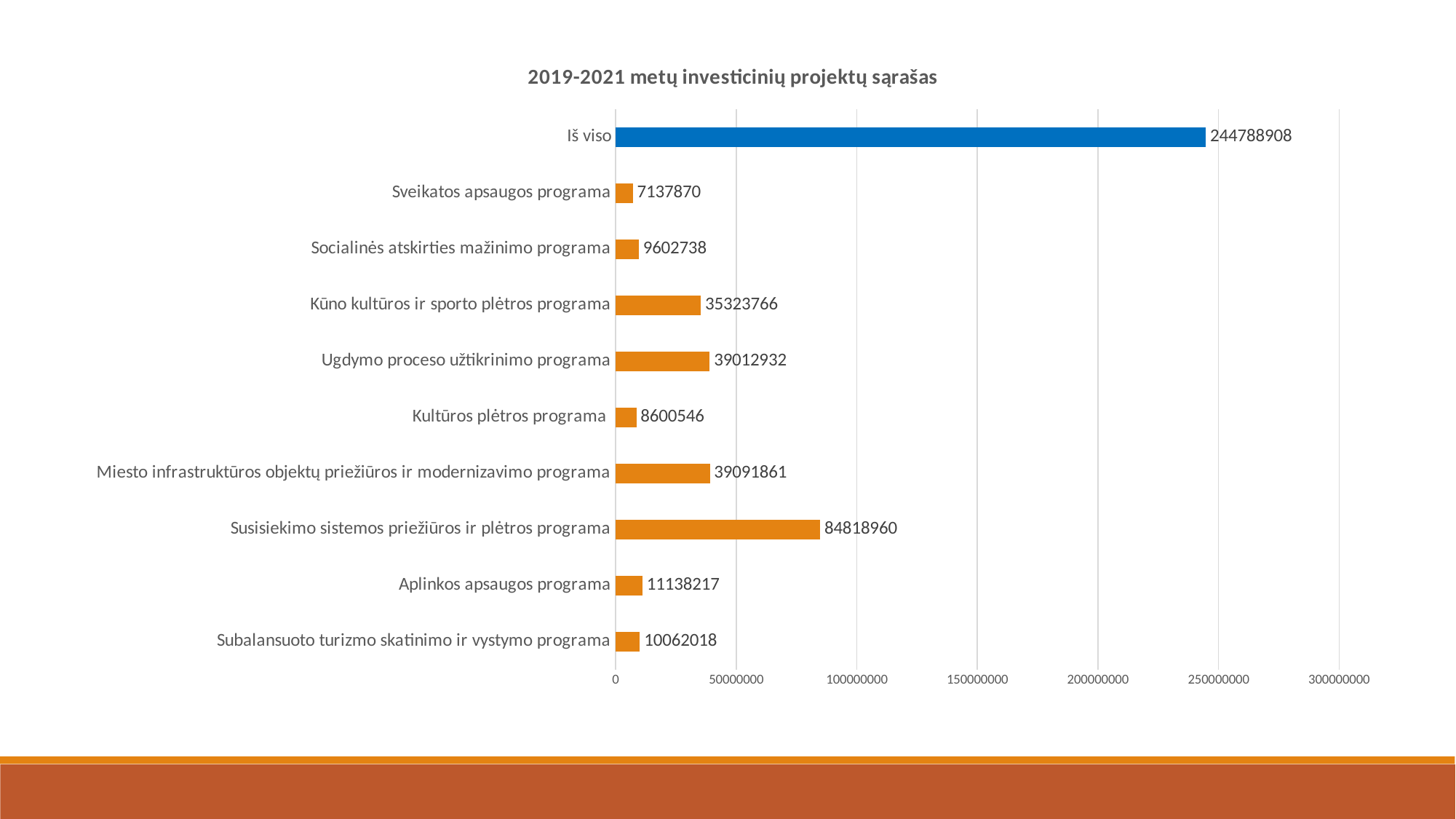
What is the value for Susisiekimo sistemos priežiūros ir plėtros programa? 84818960 What is the value for Iš viso? 244788908 How many bars are shown in the chart? 10 Which programme has the lowest value? Sveikatos apsaugos programa What is the value for Aplinkos apsaugos programa? 11138217 Which is larger: the value for Kūno kultūros ir sporto plėtros programa or for Aplinkos apsaugos programa? Kūno kultūros ir sporto plėtros programa What kind of chart is shown on the slide? bar chart Is the value for Susisiekimo sistemos priežiūros ir plėtros programa greater or less than 50000000? greater What is the value for Kultūros plėtros programa? 8600546 Excluding the Iš viso total, which programme has the highest value? Susisiekimo sistemos priežiūros ir plėtros programa What is the difference between the values for Susisiekimo sistemos priežiūros ir plėtros programa and Miesto infrastruktūros objektų priežiūros ir modernizavimo programa? 45727099 What is the title of the chart? 2019-2021 metų investicinių projektų sąrašas